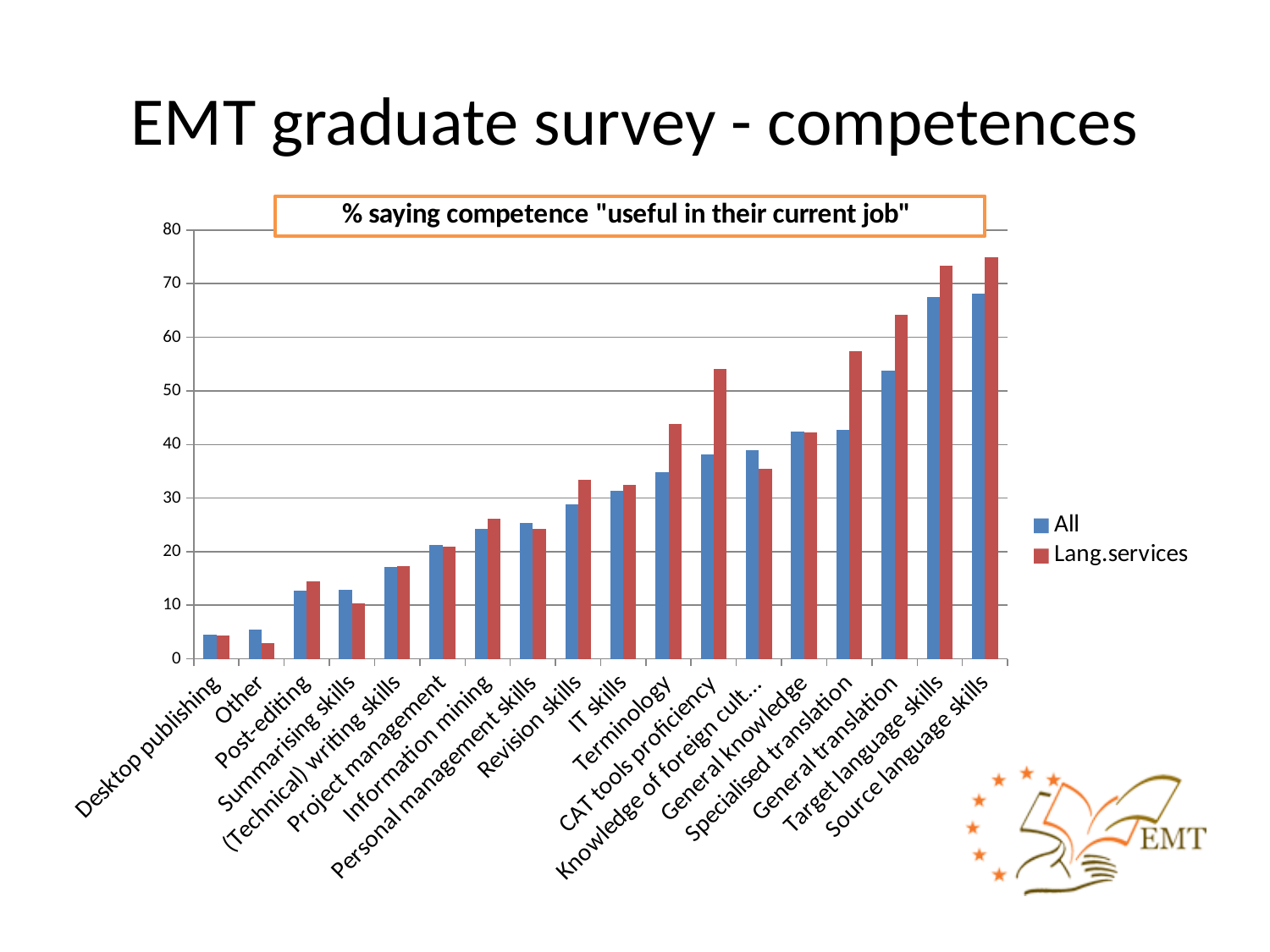
Is the Lang.services value for CAT tools proficiency greater or less than 50? greater Is the Lang.services value for Terminology greater or less than 40? greater How many competence categories are shown on the x axis? 18 Do the values generally rise or fall moving from left to right along the x axis? rise What kind of chart is shown on the slide? bar chart What are the two series named in the legend? All and Lang.services Is the All value for Target language skills greater or less than 70? less How many series does the legend list? 2 What is the title of the chart? % saying competence "useful in their current job" For Terminology, which series has the larger value, All or Lang.services? Lang.services For Summarising skills, which series has the larger value, All or Lang.services? All